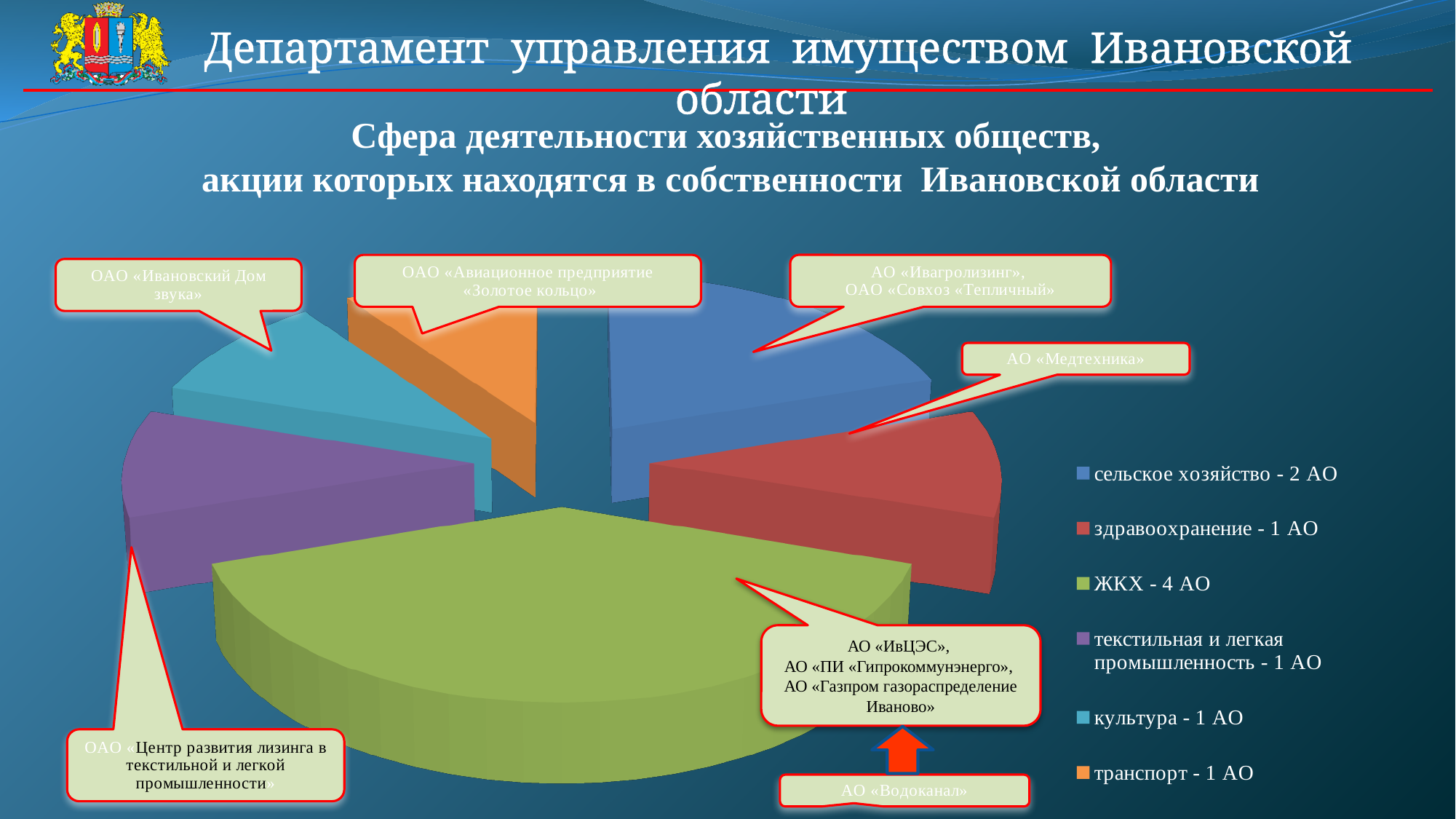
What colour is the ЖКХ slice in the pie chart? green Which company is named in the callout pointing to the здравоохранение slice? АО «Медтехника» How many categories (slices) does the pie chart have? 6 How many АО are in the category здравоохранение? 1 АО Which category has more АО: сельское хозяйство or транспорт? сельское хозяйство What is the total number of АО across all categories in the pie chart? 10 What is the difference between the number of АО in ЖКХ and in сельское хозяйство? 2 What kind of chart is shown on the slide? pie chart How many АО are in the category ЖКХ? 4 АО Which category has the largest number of АО? ЖКХ How many АО are in the category сельское хозяйство? 2 АО What share of the total number of АО does the ЖКХ slice represent? 40%